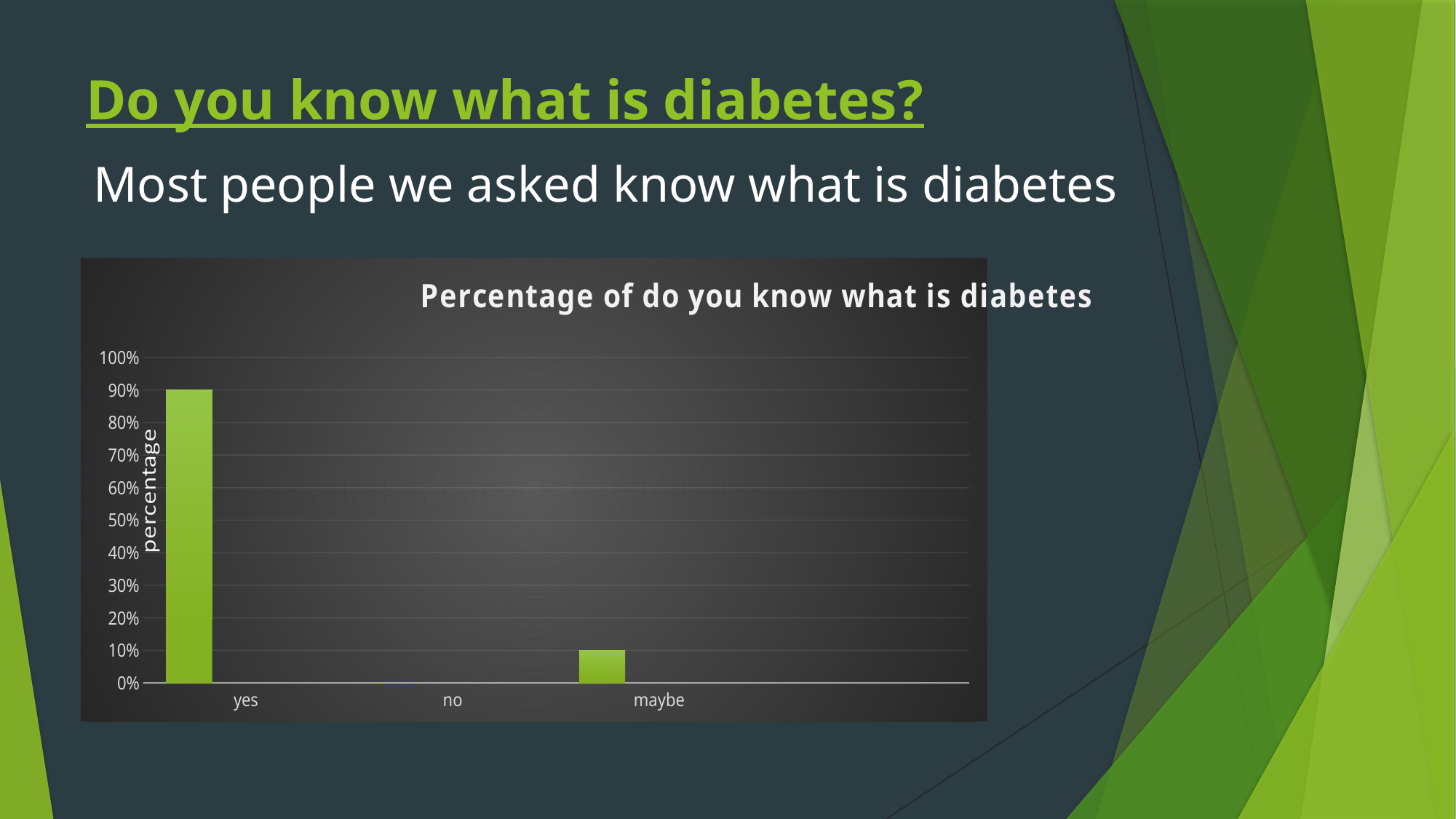
What is the label on the vertical axis of the chart? percentage How many categories are shown on the x axis? 3 Is the value for "no" greater or less than 10%? less What is the title of the chart? Percentage of do you know what is diabetes What kind of chart is shown on the slide? bar chart What is the value for "yes"? 90% Is the value for "yes" greater or less than 50%? greater Which is larger, the value for "maybe" or the value for "no"? maybe Which category has the highest value? yes What is the value for "maybe"? 10% Which category has the lowest value? no What is the difference between the values for "yes" and "maybe"? 80%